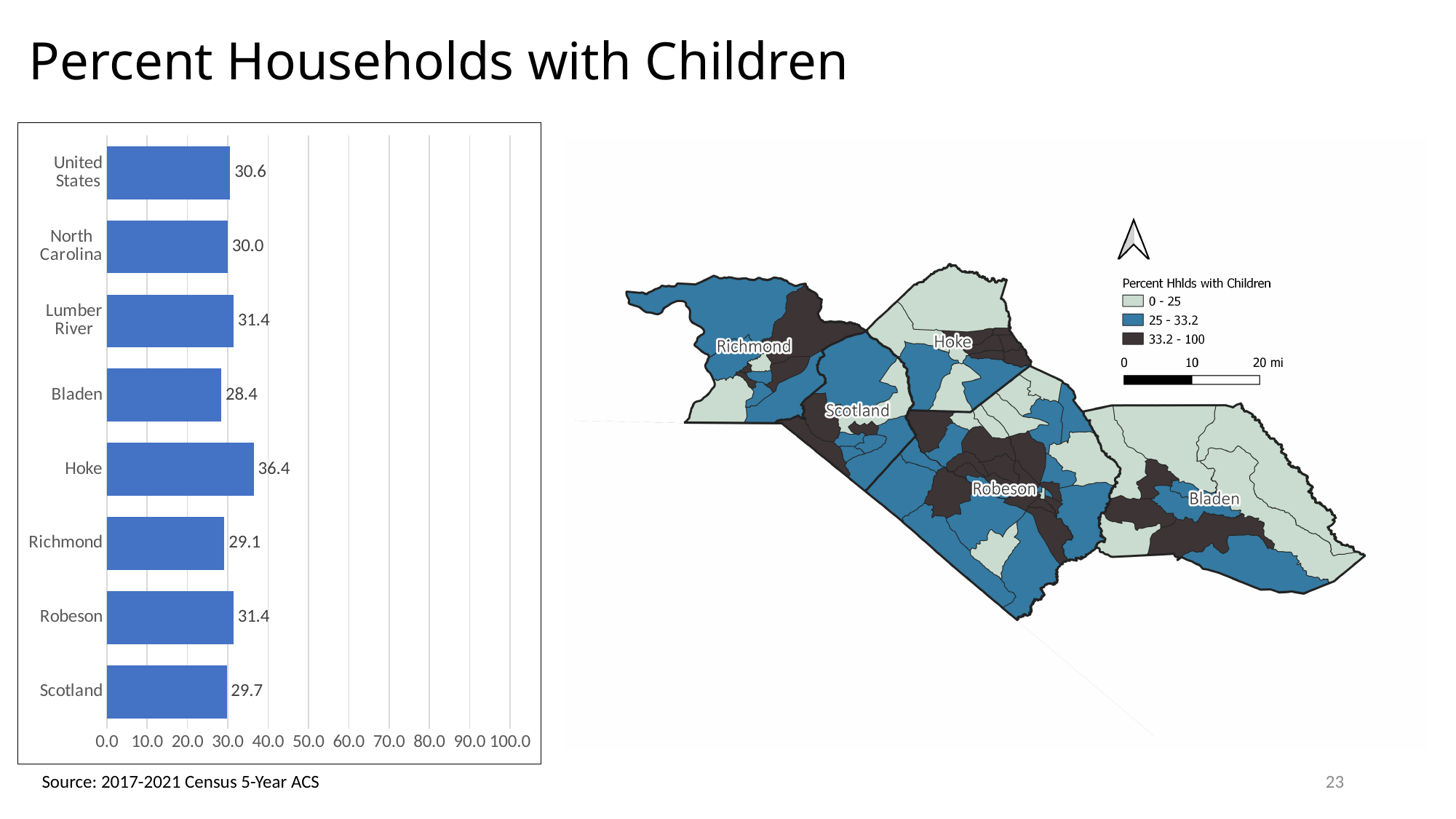
Which category has the highest value in the bar chart? Hoke Is the value for Hoke in the bar chart greater or less than 30.0? greater What is the maximum value shown on the x axis of the bar chart? 100.0 Which is larger in the bar chart, the value for Richmond or the value for Scotland? Scotland What is the value for Hoke in the bar chart? 36.4 How many categories are shown in the bar chart? 8 Which category has the lowest value in the bar chart? Bladen What is the value for Bladen in the bar chart? 28.4 What kind of chart is shown on the left of the slide? bar chart What is the value for North Carolina in the bar chart? 30.0 What is the difference between the values for Hoke and Bladen in the bar chart? 8.0 What is the difference between the values for United States and North Carolina in the bar chart? 0.6